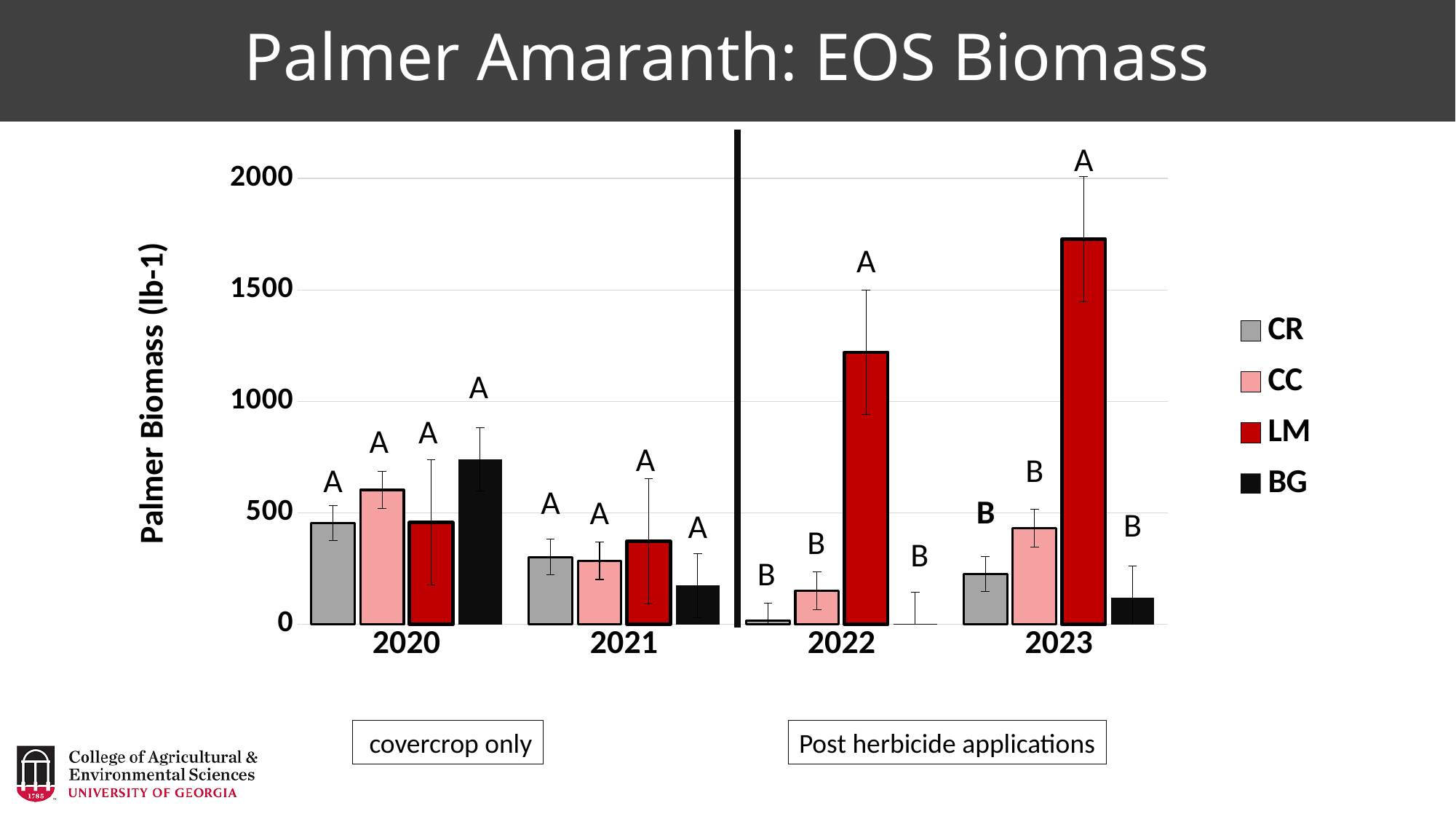
Which is larger, the LM value in 2022 or the LM value in 2023? 2023 How many series does the legend list? 4 Which series has the highest Palmer biomass in 2023? LM Which is larger in 2020, CR or CC? CC Is the value for LM in 2023 greater or less than 1500? greater Is the value for CC in 2020 greater or less than 500? greater Which series has the lowest Palmer biomass in 2021? BG Which series has the highest Palmer biomass in 2020? BG Is the value for LM in 2022 greater or less than 1000? greater Does the LM value rise or fall from 2022 to 2023? rise What kind of chart is shown on the slide? bar chart How many years are shown along the x axis? 4